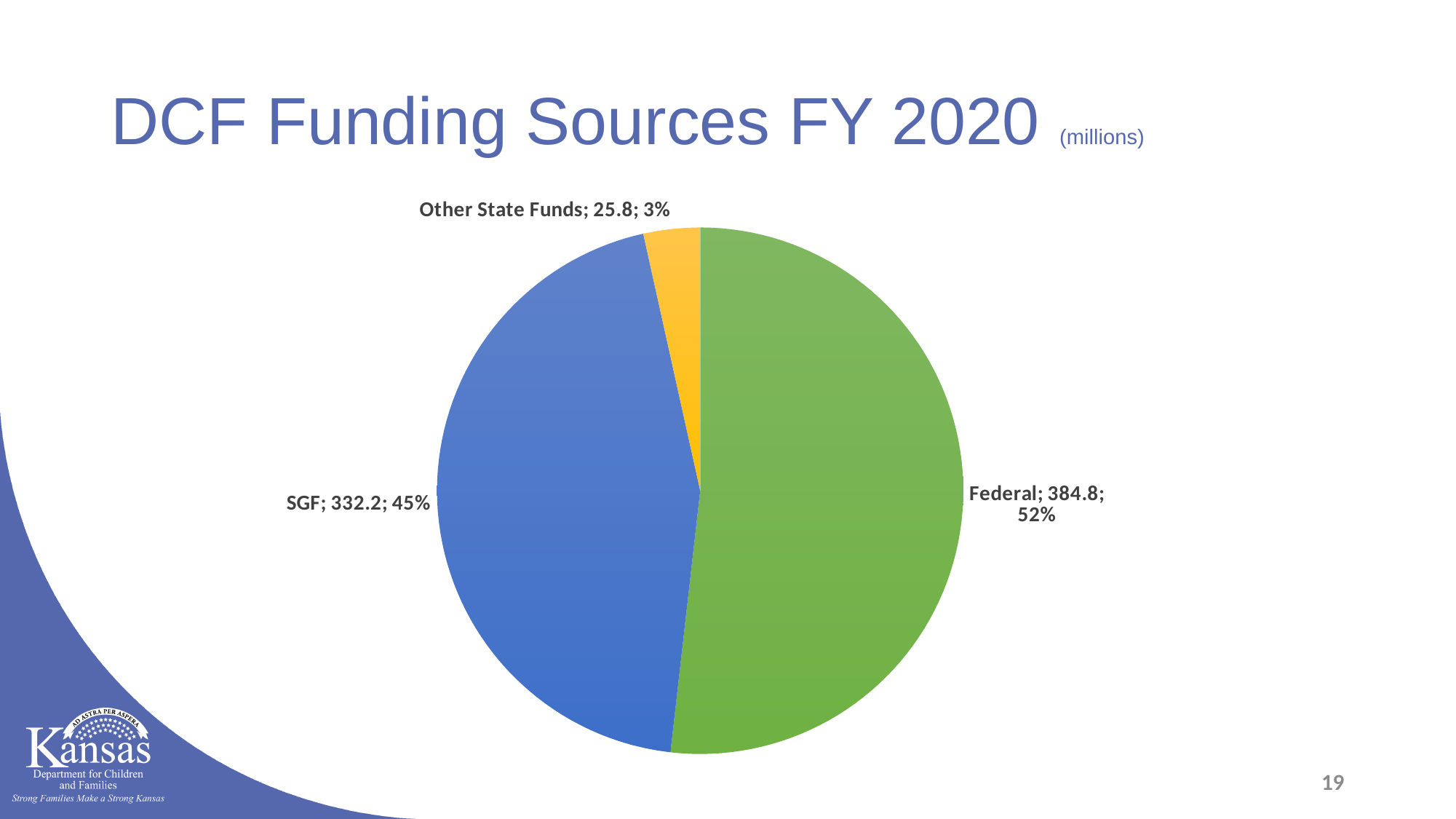
Which funding source is the smallest? Other State Funds What share of the pie does Other State Funds represent? 3% What is the value for Other State Funds? 25.8 What is the title of the chart? DCF Funding Sources FY 2020 (millions) What is the difference between the Federal and SGF values? 52.6 What is the value for Federal funding? 384.8 How many funding sources are shown in the pie chart? 3 What kind of chart is shown on the slide? pie chart What is the value for SGF? 332.2 Which is larger, Federal or SGF? Federal What share of the pie does SGF represent? 45% Which funding source is the largest? Federal